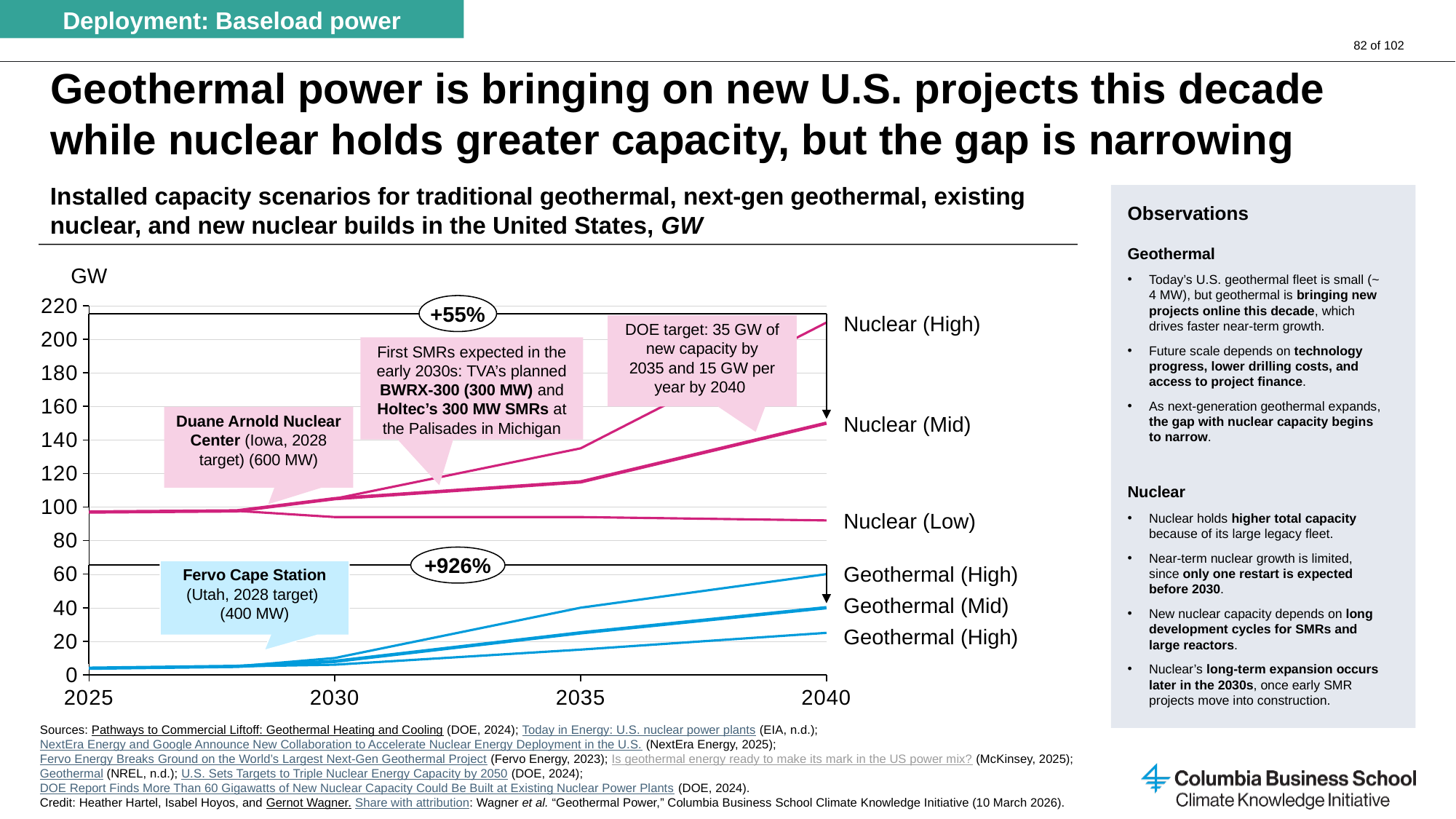
What percentage change is annotated above the geothermal lines? +926% In 2040, which is larger: Nuclear (High) or Geothermal (High)? Nuclear (High) Is the value for Nuclear (Mid) in 2040 greater or less than 140? greater What unit is shown on the y axis of the chart? GW What kind of chart is shown on the slide? line chart How many lines are plotted on the chart? 6 What percentage change is annotated above the nuclear lines? +55% Is the value for Nuclear (High) in 2040 greater or less than 200? greater How many years are labelled on the x axis of the chart? 4 Which series has the highest value in 2040? Nuclear (High) Is the value for Nuclear (Low) in 2040 greater or less than 100? less Does the Nuclear (High) line rise or fall from 2025 to 2040? rise